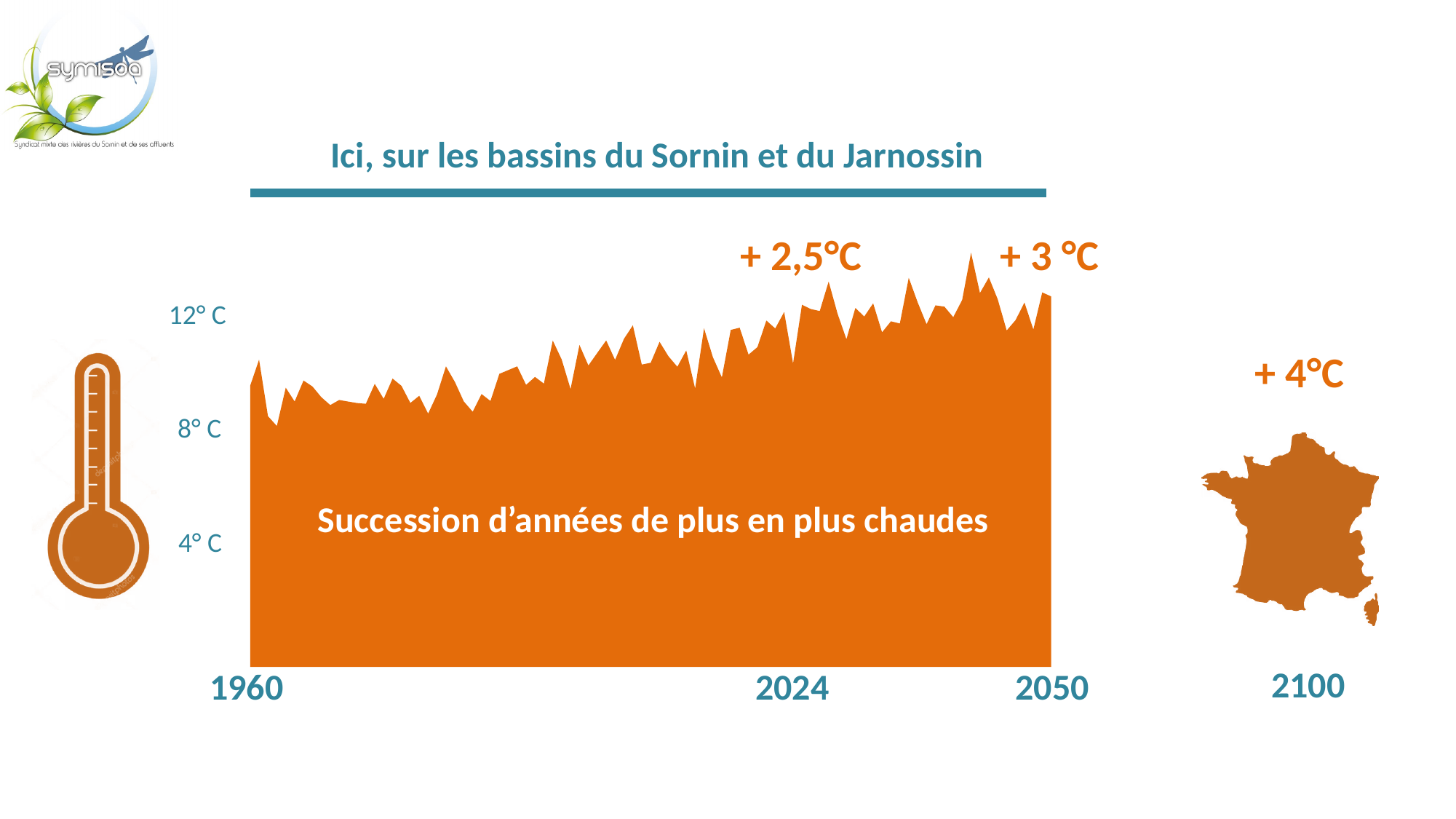
What is the title written above the chart? Ici, sur les bassins du Sornin et du Jarnossin What is the last year shown on the x axis of the chart? 2050 Is the temperature value around 2024 greater or less than 8° C? greater What kind of chart is shown on the slide? area chart What temperature increase is labelled for 2100 next to the map of France? + 4°C What is the first year shown on the x axis of the chart? 1960 How many tick labels are shown on the y axis of the chart? 3 Is the temperature value at 1960 greater or less than 12° C? less What temperature increase is labelled above the chart near 2024? + 2,5°C Is the temperature value at 1960 greater or less than 8° C? greater Do the temperature values generally rise or fall from 1960 to 2050? rise What temperature increase is labelled above the chart near 2050? + 3 °C